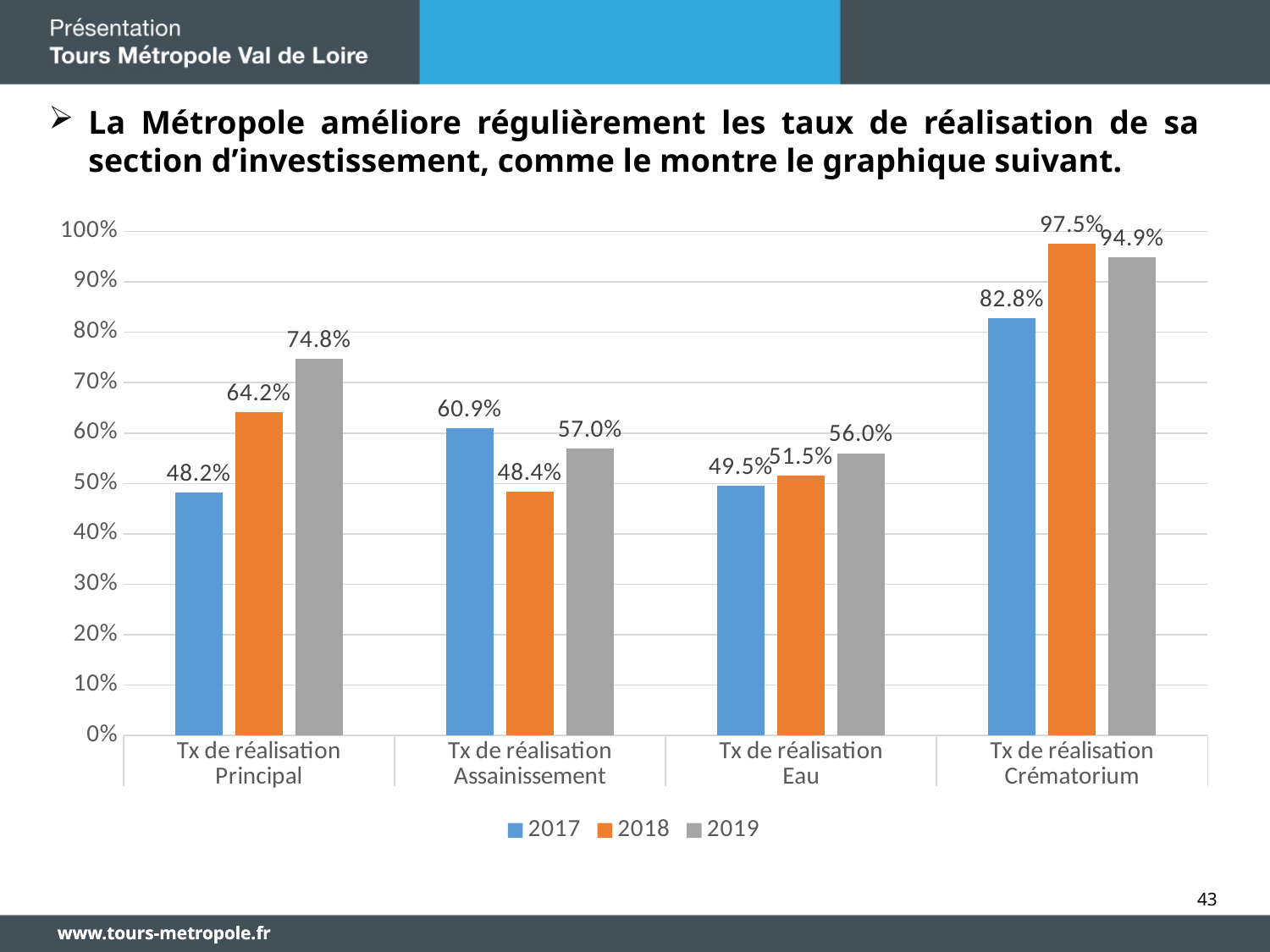
What is the 2019 value for Tx de réalisation Principal? 74.8% What is the 2017 value for Tx de réalisation Assainissement? 60.9% How many categories are shown on the x axis? 4 How many series does the legend list? 3 What is the 2018 value for Tx de réalisation Eau? 51.5% What is the difference between the 2019 and 2017 values for Tx de réalisation Principal? 26.6% What kind of chart is shown on the slide? Bar chart What is the 2018 value for Tx de réalisation Crématorium? 97.5% Which is larger for Tx de réalisation Assainissement: the 2017 value or the 2018 value? 2017 Which category has the lowest 2017 value? Tx de réalisation Principal Which colour represents the 2018 series in the legend? Orange Which category has the highest 2019 value? Tx de réalisation Crématorium